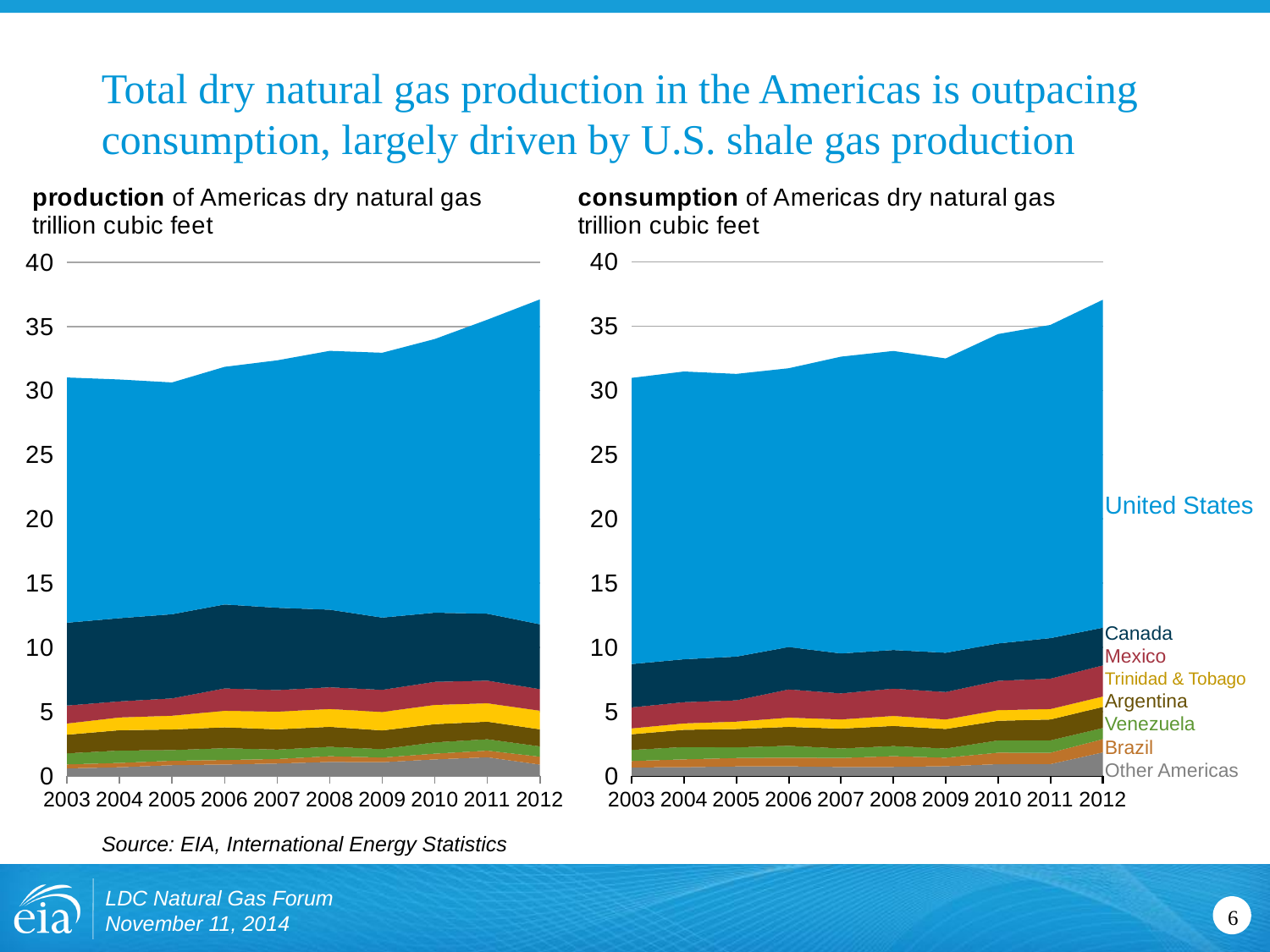
In the production of Americas dry natural gas chart, is the total for 2012 larger or smaller than the total for 2003? larger In the production of Americas dry natural gas chart, which year has the highest total? 2012 In the consumption of Americas dry natural gas chart, which series accounts for the largest share of the total? United States How many series does the legend on the consumption of Americas dry natural gas chart list? 8 What kind of chart is the production of Americas dry natural gas chart? Stacked area chart In the consumption of Americas dry natural gas chart, is the total for 2003 greater or less than 35? less In the consumption of Americas dry natural gas chart, is the total for 2009 greater or less than 30? greater In the production of Americas dry natural gas chart, is the total for 2012 greater or less than 35? greater What is the source cited for the charts? EIA, International Energy Statistics What unit is used on the y axis of both charts? trillion cubic feet In the production of Americas dry natural gas chart, does the total rise or fall from 2009 to 2012? rise How many years are shown on the x axis of the consumption of Americas dry natural gas chart? 10